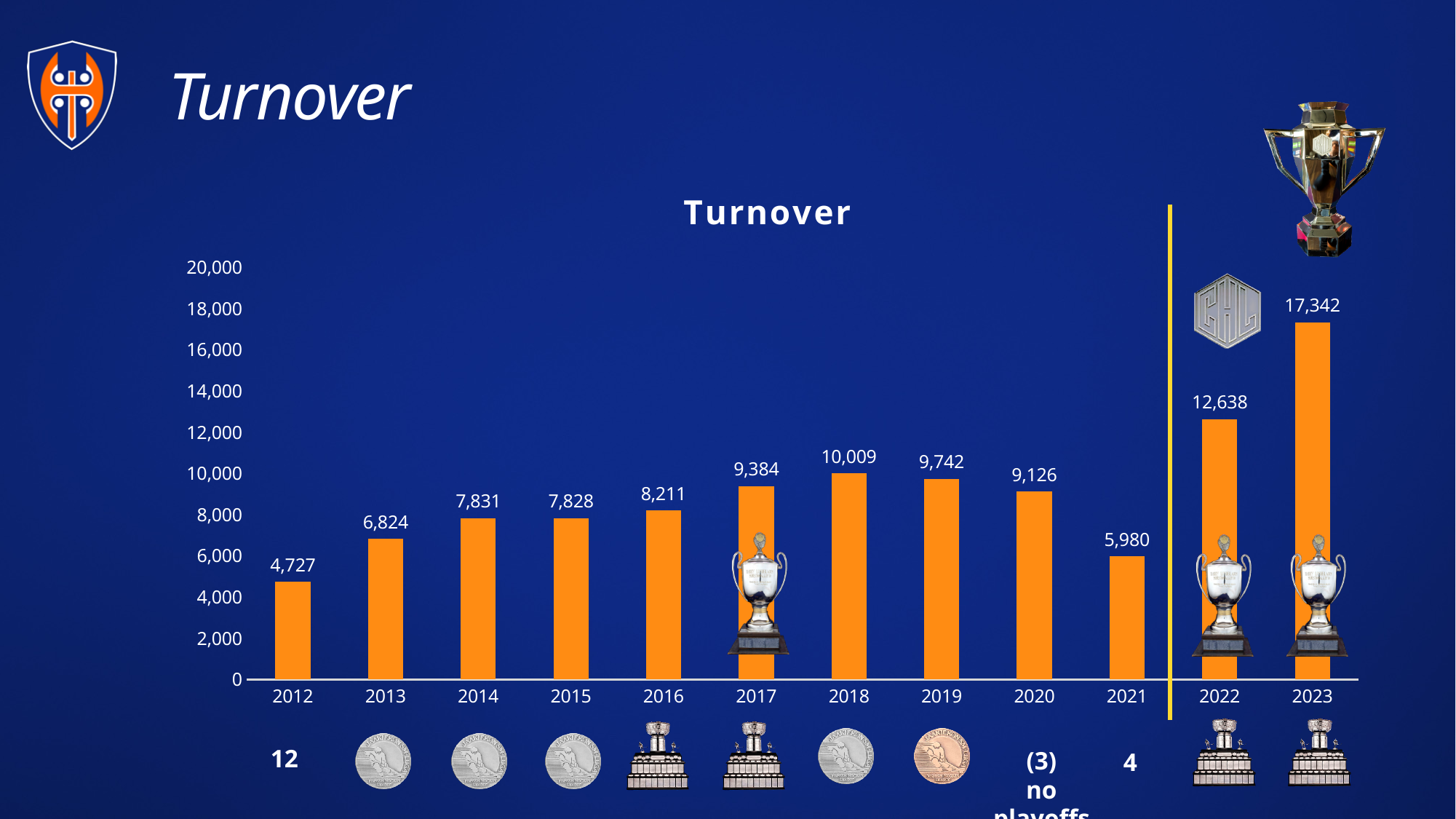
Is the turnover value for 2022 greater or less than 12,000? greater How many years are shown on the x axis of the chart? 12 What is the difference between the turnover in 2023 and in 2022? 4,704 What is the turnover value shown for 2018? 10,009 What is the turnover value shown for 2023? 17,342 Which year has the larger turnover, 2019 or 2021? 2019 What is the title of the chart? Turnover Which year has the lowest turnover? 2012 Which year has the highest turnover? 2023 What kind of chart is used to show the turnover? bar chart What is the turnover value shown for 2012? 4,727 Does the turnover rise or fall from 2020 to 2021? fall